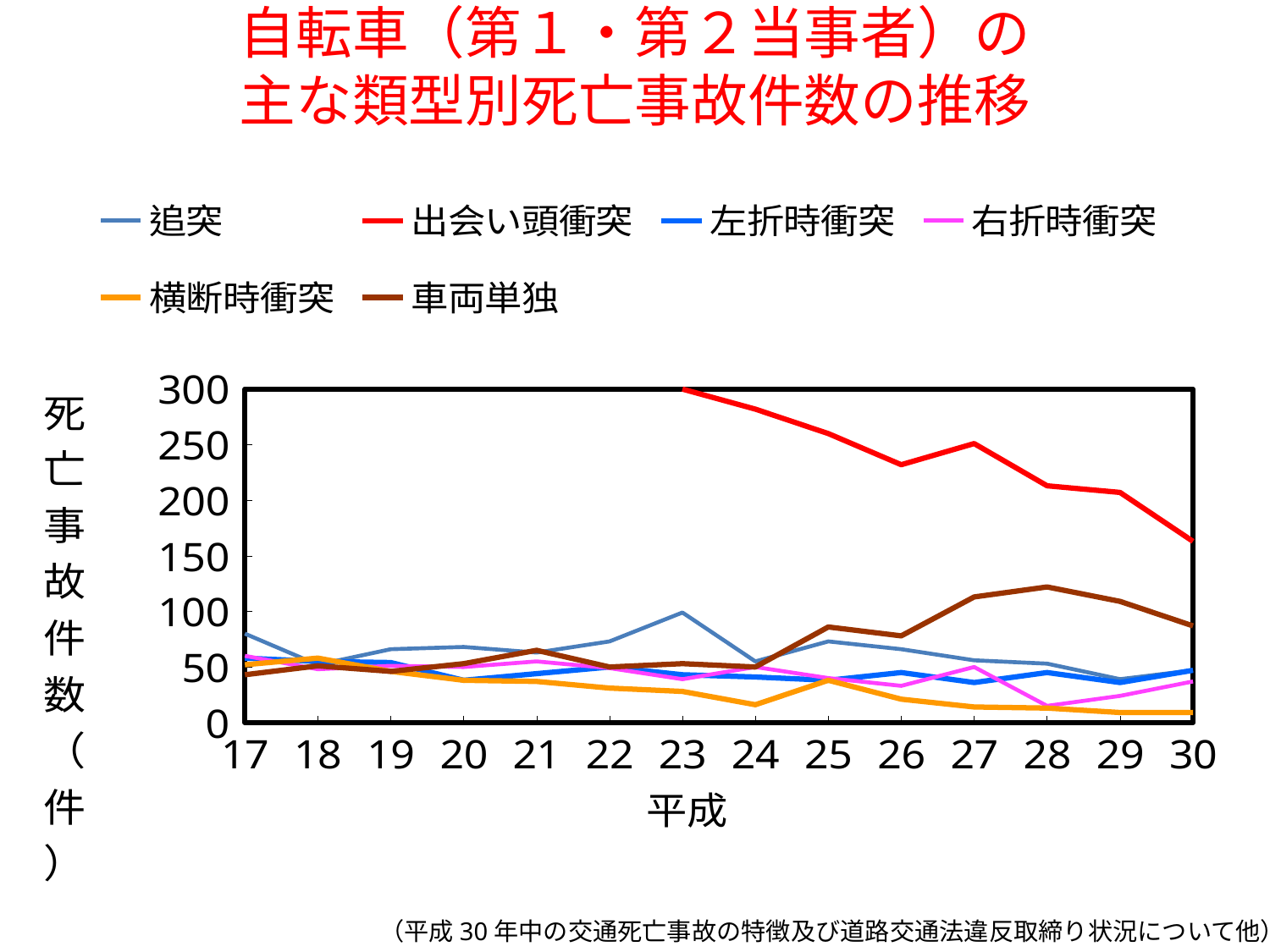
Is the value for 横断時衝突 at 平成30 greater or less than 50? less Is the value for 出会い頭衝突 at 平成30 greater or less than 150? greater What kind of chart is shown on the slide? line chart Which series has the lowest value at 平成30? 横断時衝突 How many years are shown along the x axis? 14 Does the 出会い頭衝突 series rise or fall from 平成23 to 平成30? fall At 平成28, which is larger: 車両単独 or 追突? 車両単独 At 平成23, which is larger: 追突 or 車両単独? 追突 How many series does the legend list? 6 Is the value for 車両単独 at 平成28 greater or less than 100? greater What is the label of the x axis? 平成 Which series has the highest value at 平成30? 出会い頭衝突